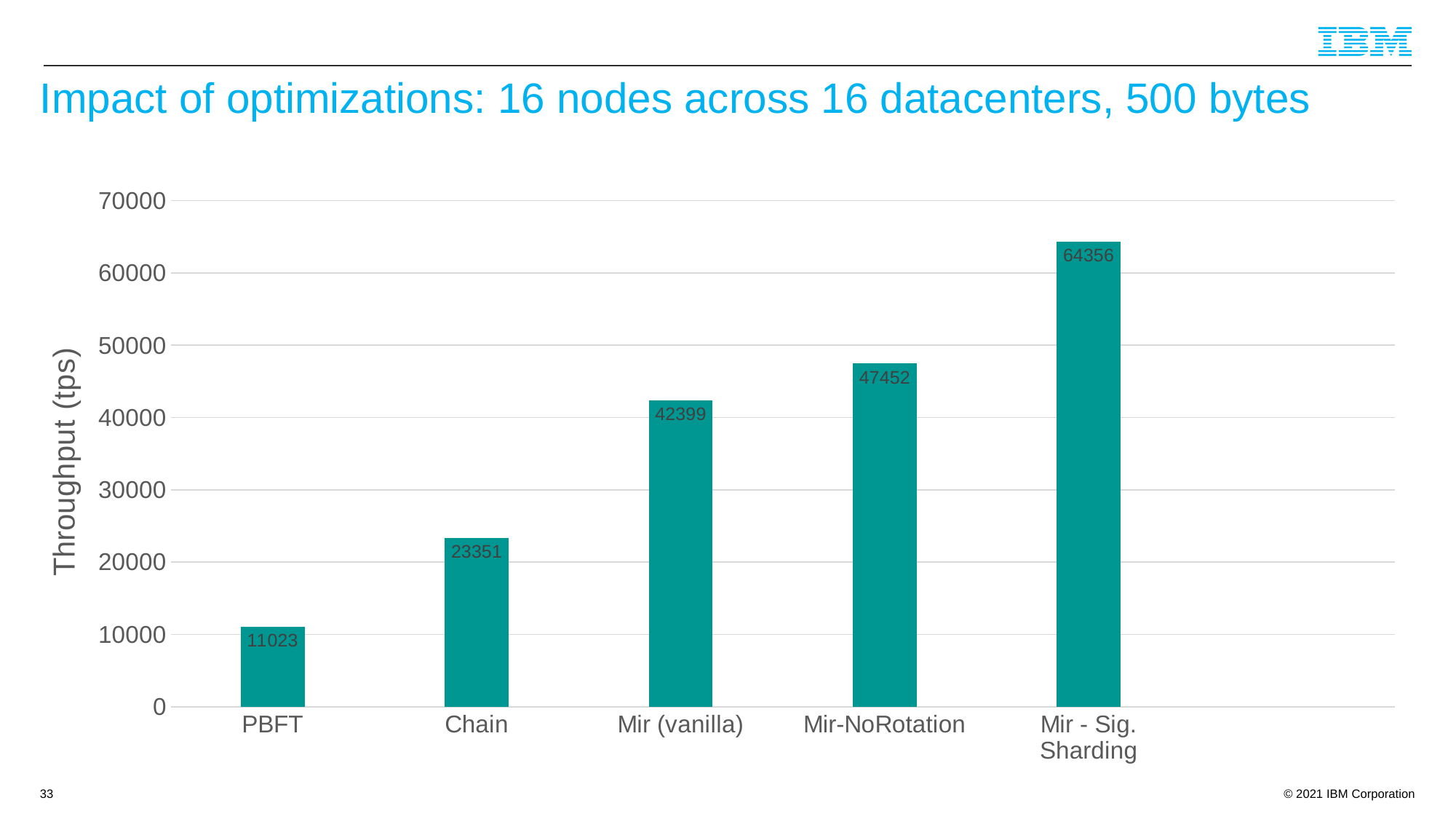
What is the throughput for Mir (vanilla)? 42399 How many categories are shown on the x axis? 5 What kind of chart is shown on the slide? Bar chart What is the throughput for PBFT? 11023 Do the throughput values rise or fall from left to right along the x axis? Rise Which has a higher throughput, Chain or Mir (vanilla)? Mir (vanilla) What is the difference in throughput between Mir - Sig. Sharding and Mir-NoRotation? 16904 What is the throughput for Chain? 23351 Which category has the highest throughput? Mir - Sig. Sharding Which category has the lowest throughput? PBFT What is the throughput for Mir - Sig. Sharding? 64356 What is the throughput for Mir-NoRotation? 47452